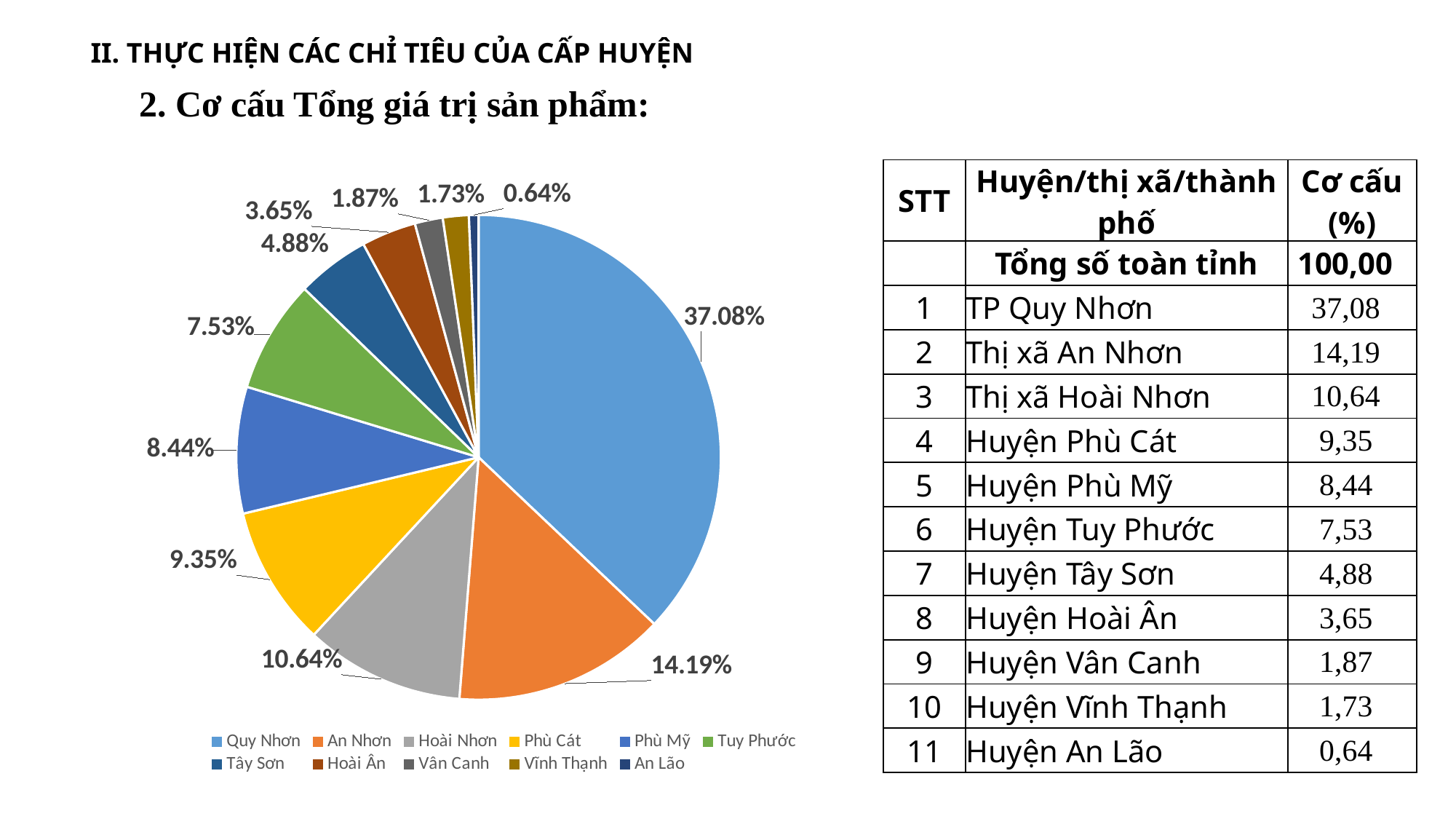
How many slices does the pie chart have? 11 What is the value shown for Tuy Phước in the pie chart? 7.53% Which is larger, the slice for Tây Sơn or the slice for Hoài Ân? Tây Sơn Which category has the largest slice of the pie? Quy Nhơn What colour is the slice for An Nhơn? Orange What is the difference between the values for Phù Cát and Phù Mỹ? 0.91% What is the value shown for Vĩnh Thạnh in the pie chart? 1.73% Which category has the smallest slice of the pie? An Lão What share of the pie does Quy Nhơn hold? 37.08% What kind of chart is shown on the slide? Pie chart What is the value shown for Hoài Nhơn in the pie chart? 10.64% What is the difference between the values for Quy Nhơn and An Nhơn? 22.89%